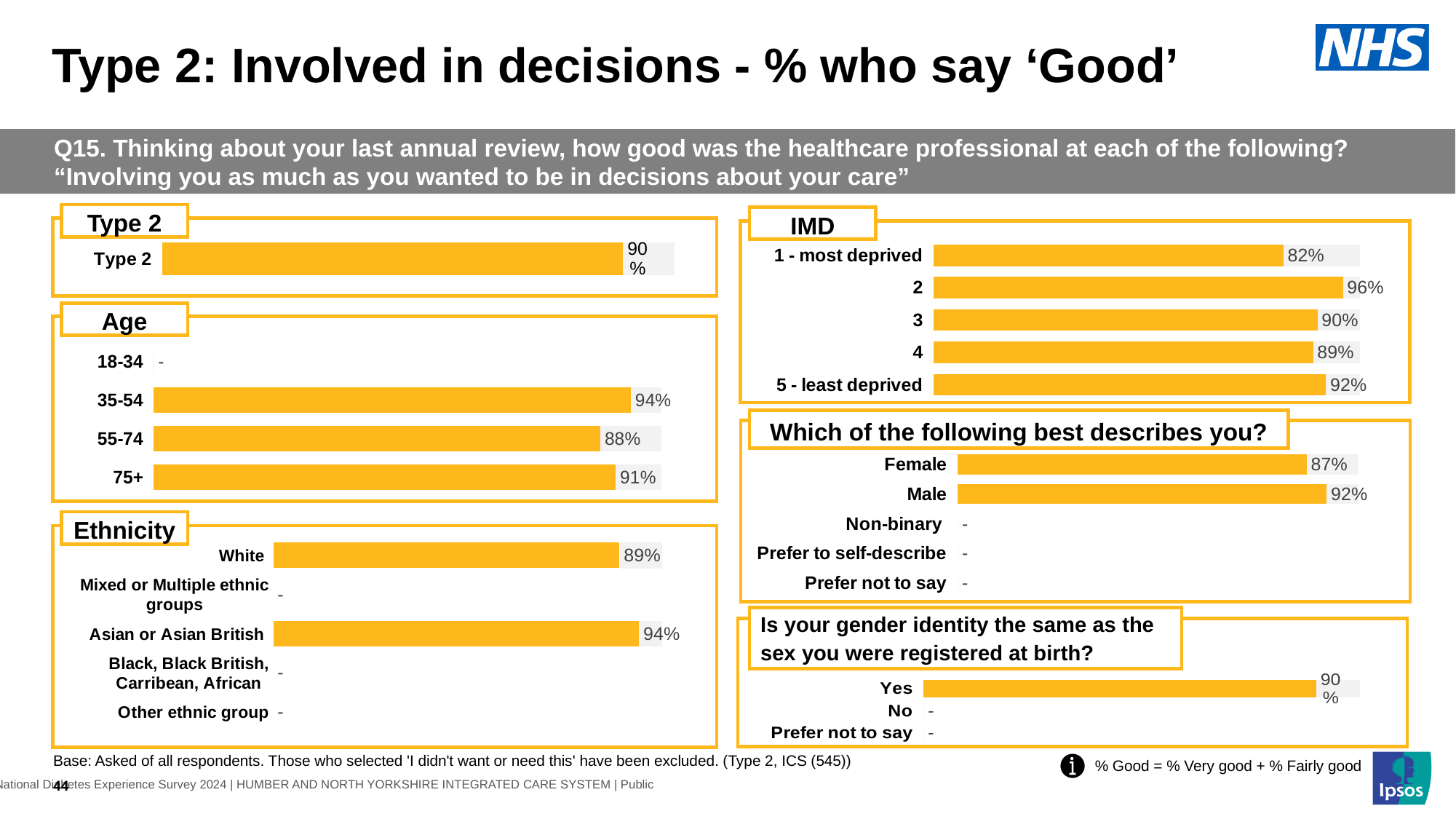
In the 'Which of the following best describes you?' chart, what is the value for Female? 87% In the Type 2 chart, what percentage of Type 2 respondents say 'Good'? 90% In the IMD chart, what is the difference between the values for 2 and 1 - most deprived? 14 percentage points In the Age chart, what is the value for the 35-54 age group? 94% In the IMD chart, which IMD group has the lowest percentage? 1 - most deprived In the IMD chart, which IMD group has the highest percentage? 2 In the Ethnicity chart, which is higher: White or Asian or Asian British? Asian or Asian British In the Age chart, what is the difference between the 35-54 and 55-74 values? 6 percentage points In the Age chart, which age group with a plotted value has the lowest percentage? 55-74 In the 'Which of the following best describes you?' chart, which is higher: Female or Male? Male In the Ethnicity chart, what is the value for Asian or Asian British? 94% In the 'Is your gender identity the same as the sex you were registered at birth?' chart, what is the value for Yes? 90%